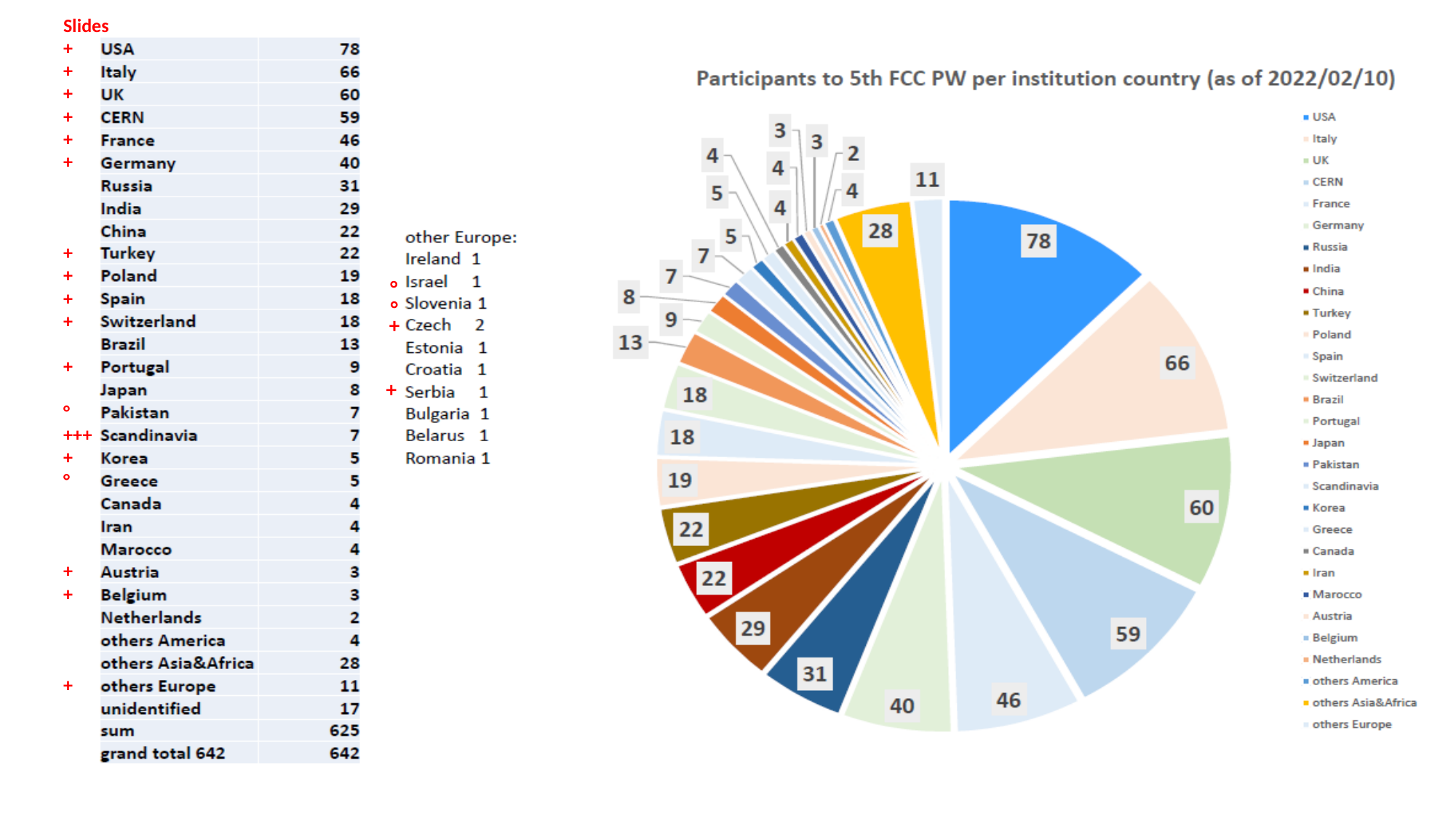
In the pie chart, how many participants are from USA? 78 Which category has the largest slice in the pie chart? USA In the pie chart, what is the value for Italy? 66 Which category has the smallest slice in the pie chart? Netherlands What is the title of the pie chart? Participants to 5th FCC PW per institution country (as of 2022/02/10) What type of chart is shown on the slide? pie chart In the pie chart, what is the value for others Asia&Africa? 28 In the pie chart, what is the value for CERN? 59 In the pie chart, which is larger: the value for UK or the value for CERN? UK How many slices does the pie chart have? 29 In the pie chart, what is the value for Germany? 40 What is the difference between the values for USA and Italy in the pie chart? 12